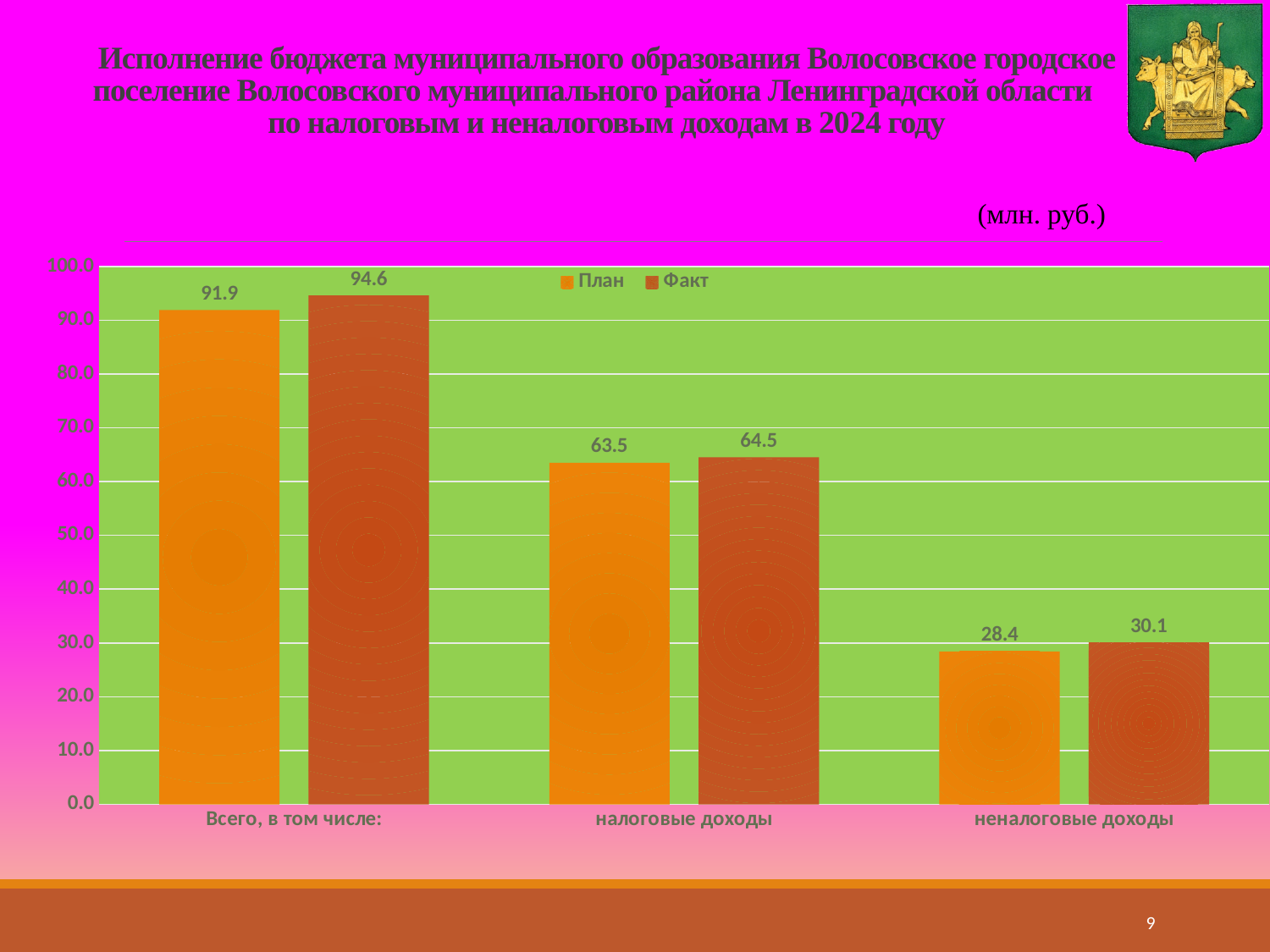
Which is larger for налоговые доходы, the План value or the Факт value? Факт Which category has the highest Факт value? Всего, в том числе: What is the difference between the Факт and План values for Всего, в том числе:? 2.7 Is the План value for Всего, в том числе: greater or less than 90.0? greater How many series does the legend list? 2 What is the Факт value for неналоговые доходы? 30.1 What is the difference between the Факт and План values for неналоговые доходы? 1.7 Which category has the lowest План value? неналоговые доходы What is the План value for налоговые доходы? 63.5 How many categories are shown on the x axis? 3 What kind of chart is shown on the slide? bar chart What is the Факт value for Всего, в том числе:? 94.6